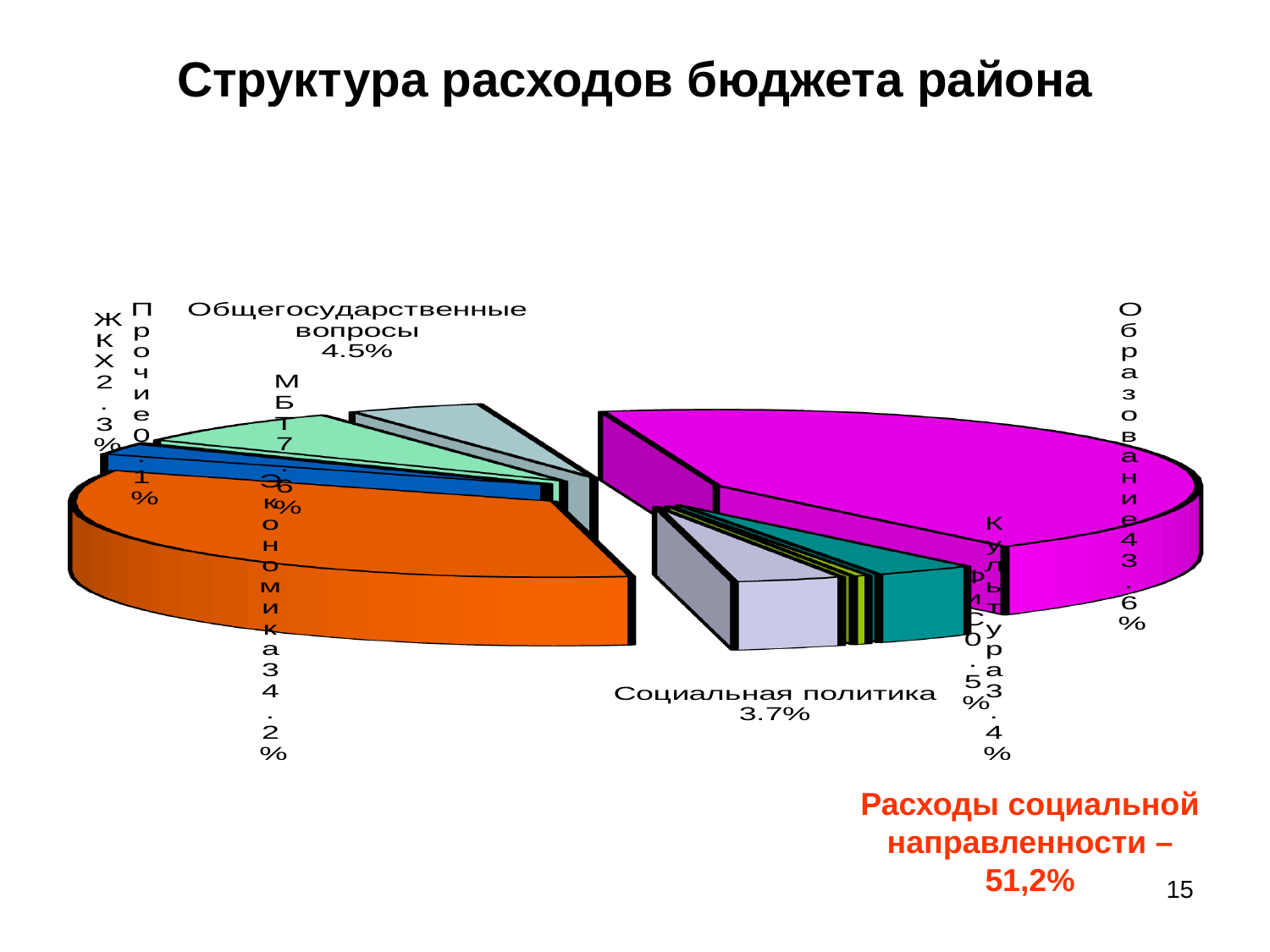
What share is shown for Общегосударственные вопросы? 4.5% What share of the budget expenditure goes to Экономика? 34.2% What share is shown for Социальная политика? 3.7% What share is shown for ЖКХ? 2.3% Which category has the largest share of the pie? Образование What share of the budget expenditure goes to Образование? 43.6% What share is shown for МБТ? 7.6% Which labelled category has the smallest share of the pie? Прочие What is the difference in percentage points between the shares for Образование and Экономика? 9.4 What is the title of the chart on the slide? Структура расходов бюджета района What kind of chart is shown on the slide? pie chart Which is larger, the share for Образование or the share for Экономика? Образование